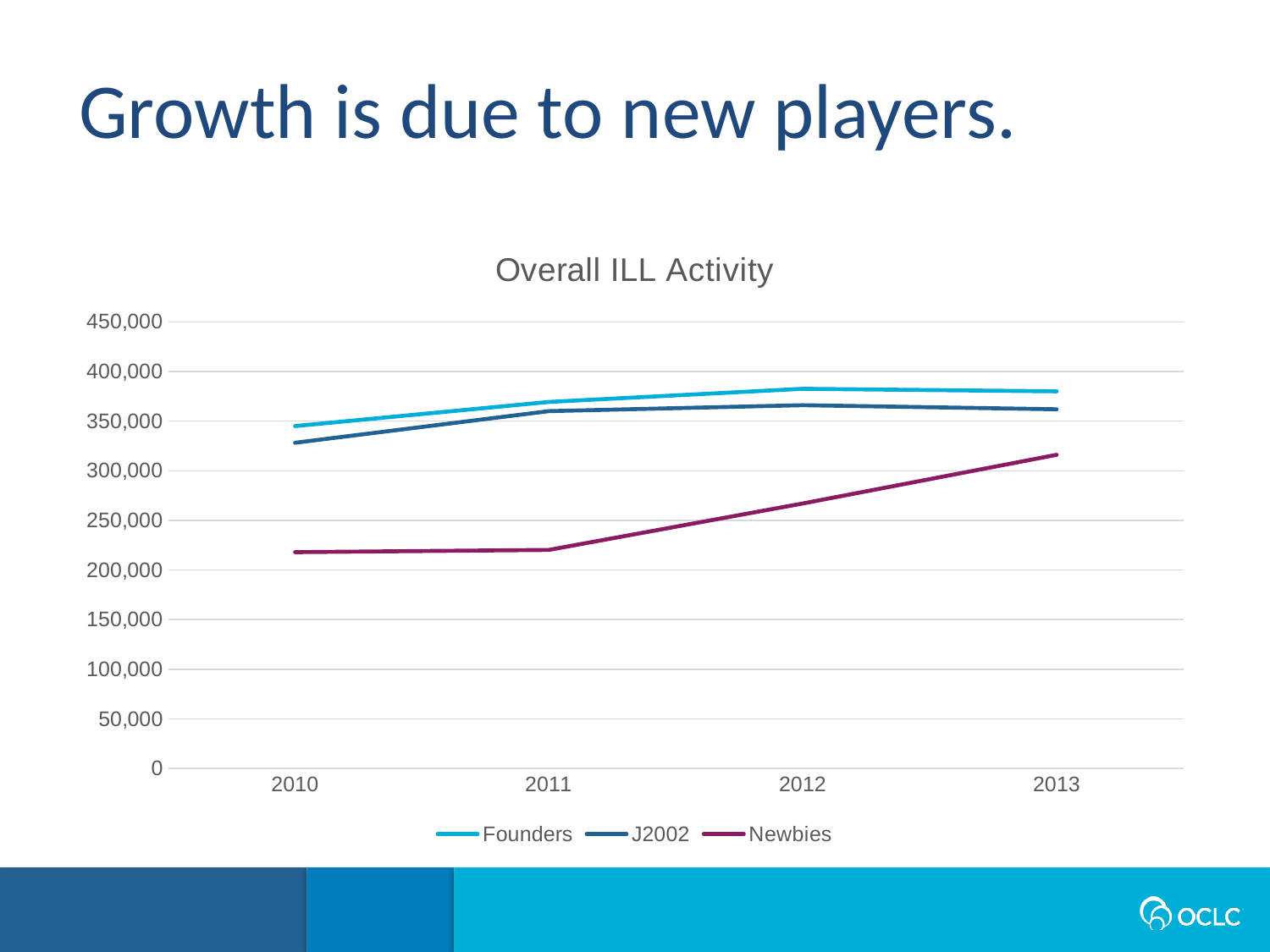
Is the value for J2002 in 2010 greater or less than 350,000? less How many years are shown on the x axis? 4 What kind of chart is shown on the slide? line chart Which series has the lowest value in 2013? Newbies Is the value for Founders in 2012 greater or less than 350,000? greater Which is larger in 2013, the value for Founders or the value for Newbies? Founders Do the values for Newbies rise or fall from 2011 to 2013? rise What is the title of the chart? Overall ILL Activity How many series does the legend list? 3 Which series has the highest value in 2010? Founders Is the value for Newbies in 2010 greater or less than 250,000? less